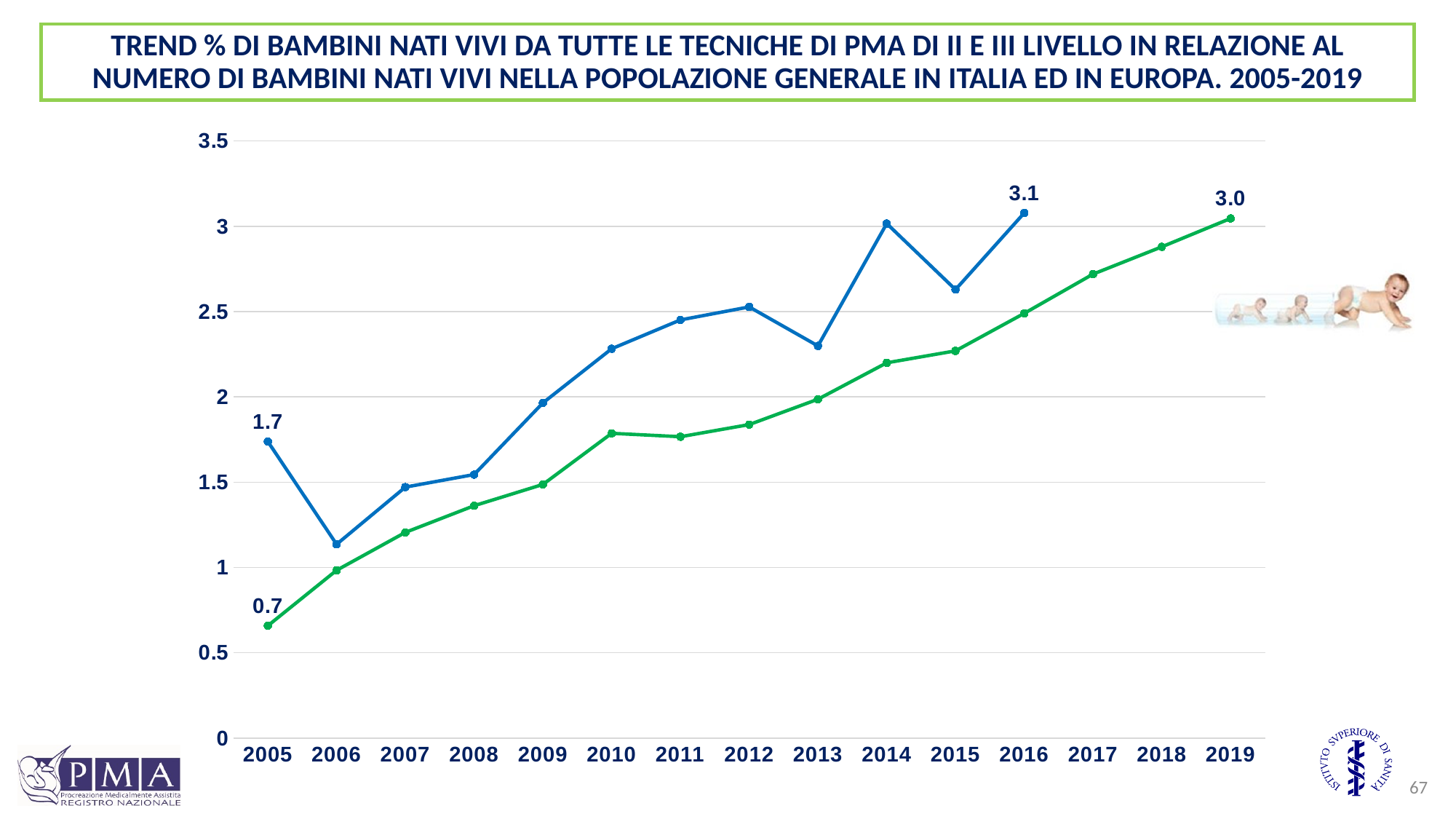
What kind of chart is shown on the slide? line chart In which year does the blue line reach its lowest value? 2006 What is the value of the blue line in 2016? 3.1 Is the value of the green line in 2017 greater or less than 2.5? greater What is the value of the green line in 2019? 3.0 How many years are shown on the x axis of the chart? 15 In 2005, which line has the higher value, the blue or the green? blue Is the value of the green line in 2010 greater or less than 2? less What is the value of the green line in 2005? 0.7 By how much did the blue line increase from 2005 to 2016? 1.3 By how much did the green line increase from 2005 to 2019? 2.4 What is the value of the blue line in 2005? 1.7